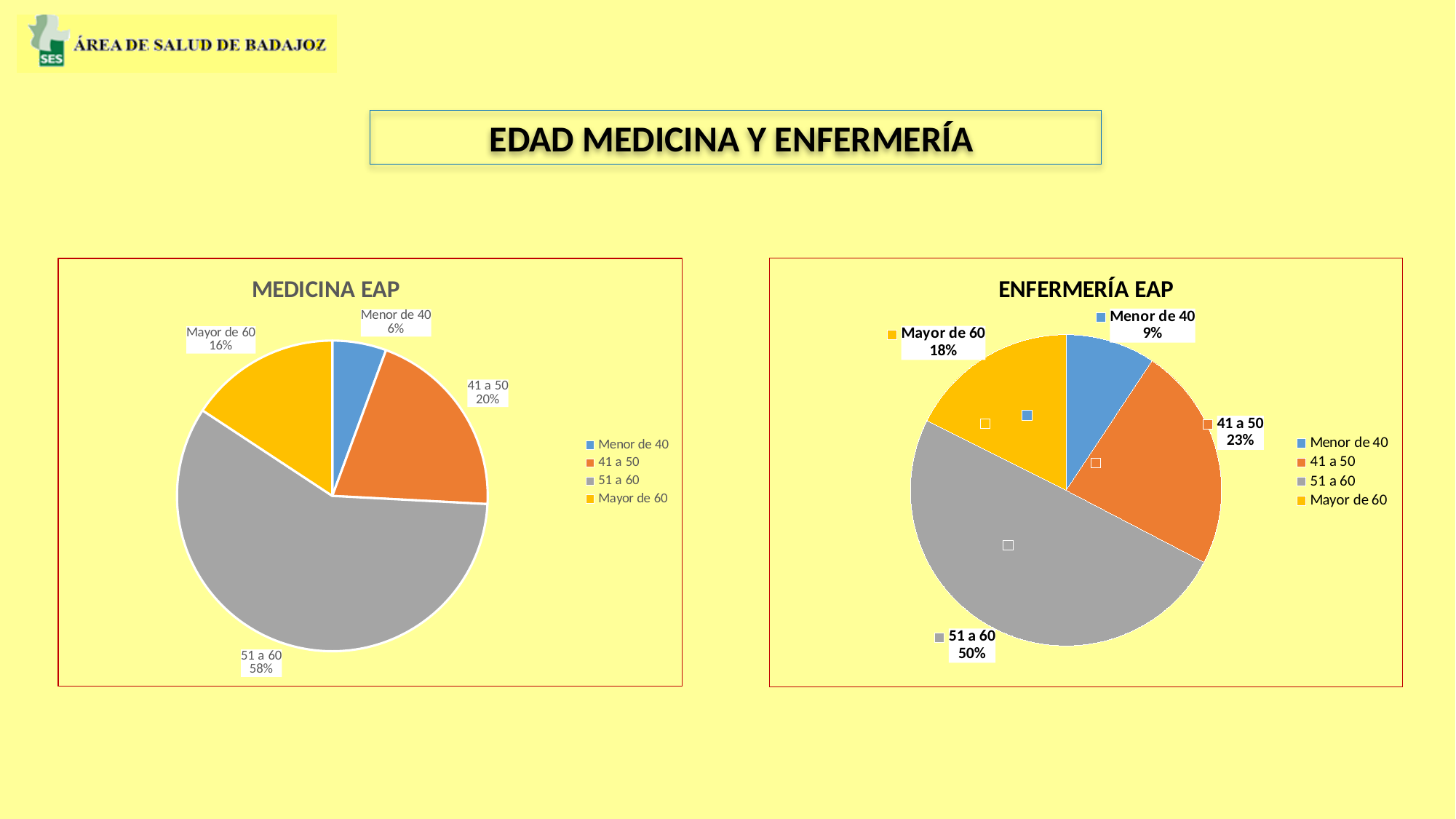
In the MEDICINA EAP chart, what is the difference between the 41 a 50 share and the Mayor de 60 share? 4% What is the title of the chart on the left of the slide? MEDICINA EAP In the ENFERMERÍA EAP chart, what share does the Mayor de 60 slice have? 18% In the MEDICINA EAP chart, what share does the 51 a 60 slice have? 58% How many slices does the MEDICINA EAP chart have? 4 In the ENFERMERÍA EAP chart, what share does the 41 a 50 slice have? 23% In the MEDICINA EAP chart, which category has the smallest slice? Menor de 40 In the ENFERMERÍA EAP chart, which category has the largest slice? 51 a 60 In the ENFERMERÍA EAP chart, which is larger: the Mayor de 60 slice or the Menor de 40 slice? Mayor de 60 How many entries does the legend of the ENFERMERÍA EAP chart list? 4 What kind of chart is the ENFERMERÍA EAP chart? Pie chart